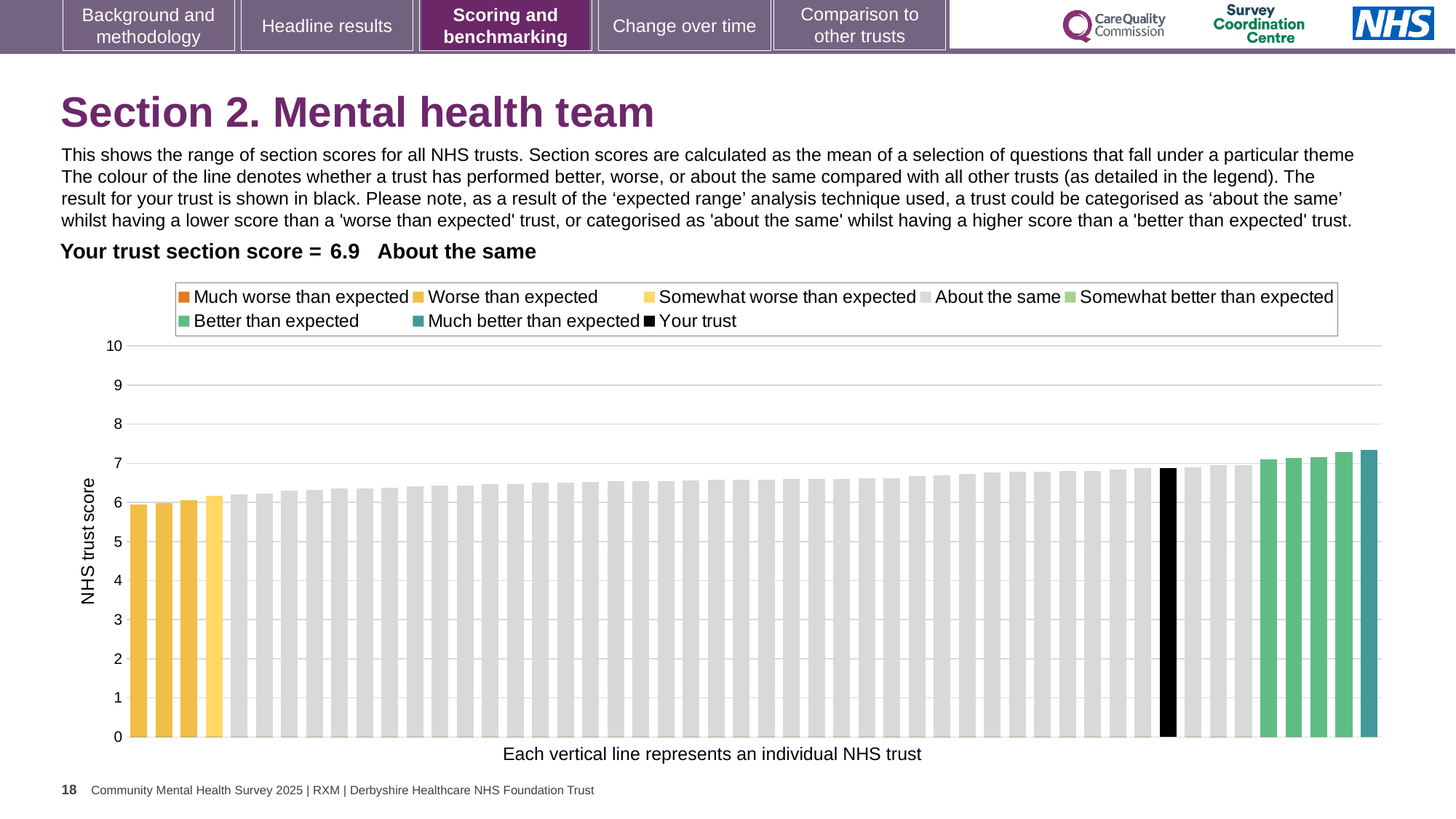
Is the value of the tallest bar greater or less than 7? greater Is the value of the black 'Your trust' bar greater or less than 5? greater Is the value of the tallest bar greater or less than 8? less Do the bar values rise or fall from left to right along the x axis? rise Which category is your trust placed in for this section? About the same Which legend category does the lowest bar belong to? Worse than expected What is the label on the vertical axis of the chart? NHS trust score Which legend category does the tallest bar belong to? Much better than expected What kind of chart is shown on the slide? bar chart How many entries does the chart legend list? 8 What is the section score for your trust shown on the slide? 6.9